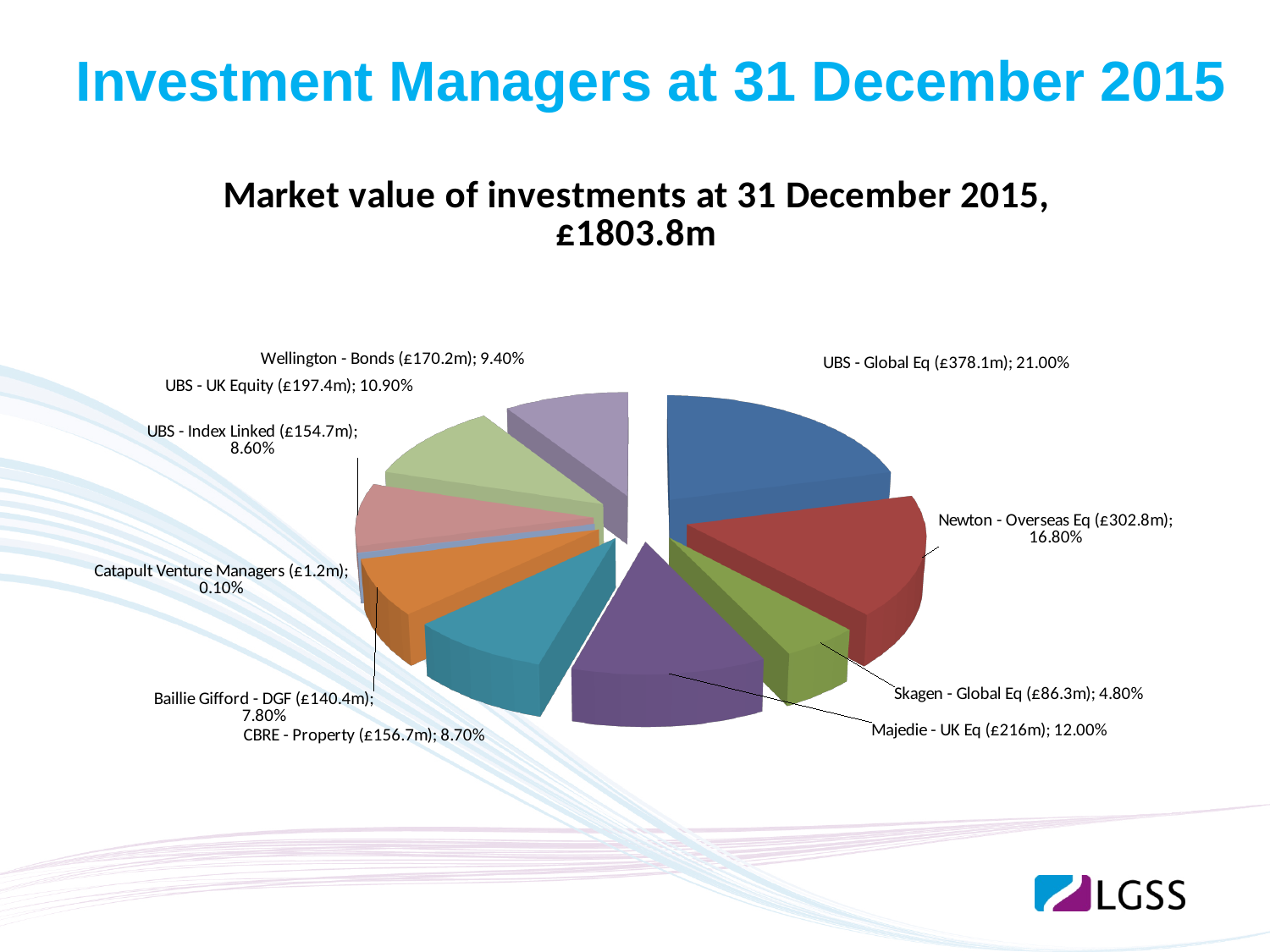
Which investment manager has the smallest slice of the pie? Catapult Venture Managers Which has the larger market value, Wellington - Bonds or CBRE - Property? Wellington - Bonds What is the market value shown for Baillie Gifford - DGF? £140.4m How many slices does the pie chart have? 10 What is the market value shown for UBS - Global Eq? £378.1m What total market value is stated in the chart title? £1803.8m What kind of chart is shown on the slide? Pie chart What is the market value shown for Majedie - UK Eq? £216m What is the difference in market value between UBS - Global Eq and Newton - Overseas Eq? £75.3m Which investment manager has the largest slice of the pie? UBS - Global Eq What percentage share of the pie does Newton - Overseas Eq hold? 16.80% What percentage share does Skagen - Global Eq hold? 4.80%